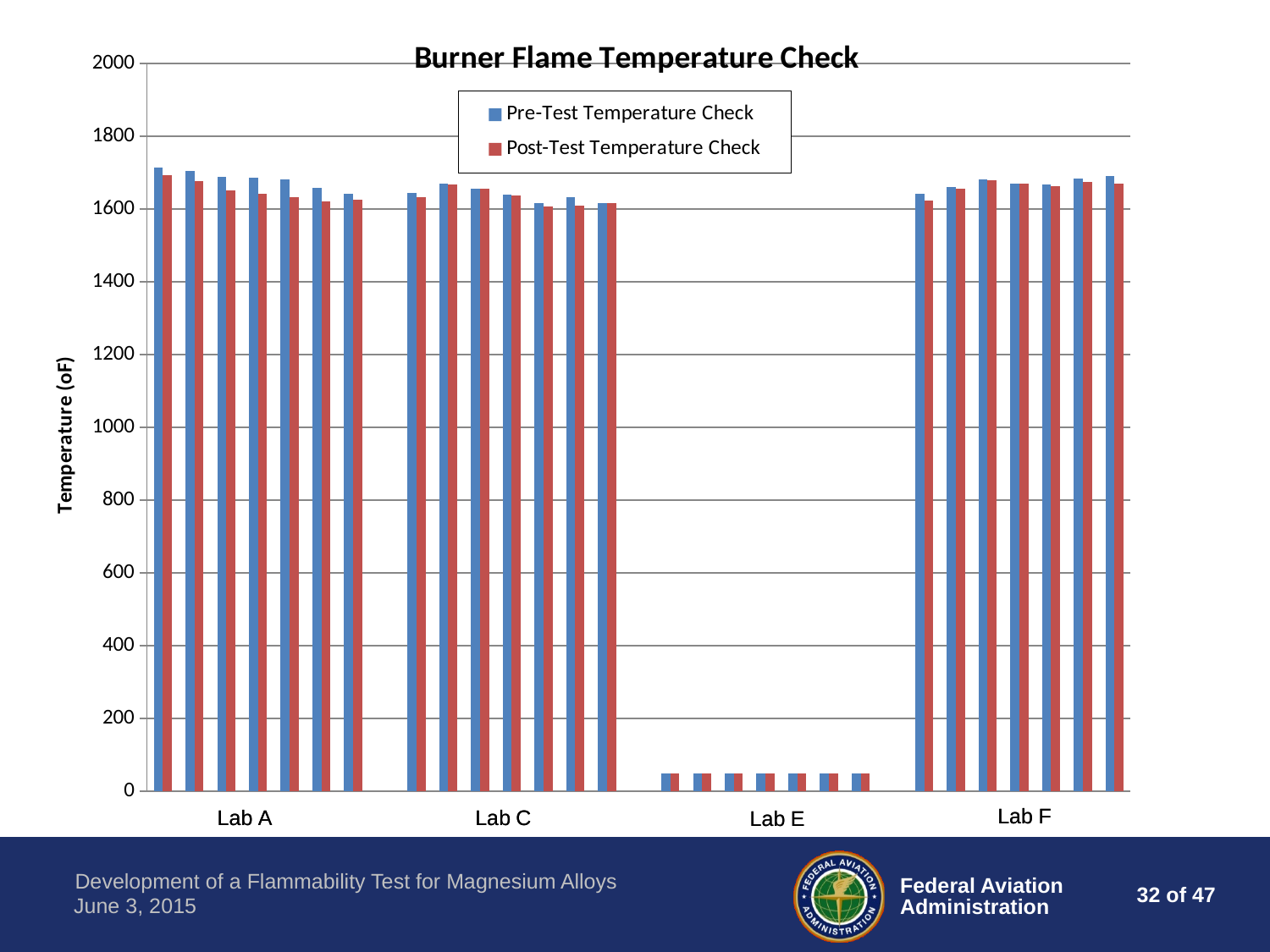
Are the temperature values for Lab E greater or less than 200? less Are the temperature values for Lab C greater or less than 1800? less What is the maximum value shown on the y axis of the chart? 2000 Which lab has higher temperature values, Lab A or Lab E? Lab A Which series is shown in blue in the chart? Pre-Test Temperature Check What is the title of the chart? Burner Flame Temperature Check How many series does the legend list in the Burner Flame Temperature Check chart? 2 Are the temperature values for Lab F greater or less than 1400? greater How many labs are shown along the x axis of the chart? 4 Which lab has the lowest temperature values in the chart? Lab E What kind of chart is shown on the slide? Bar chart